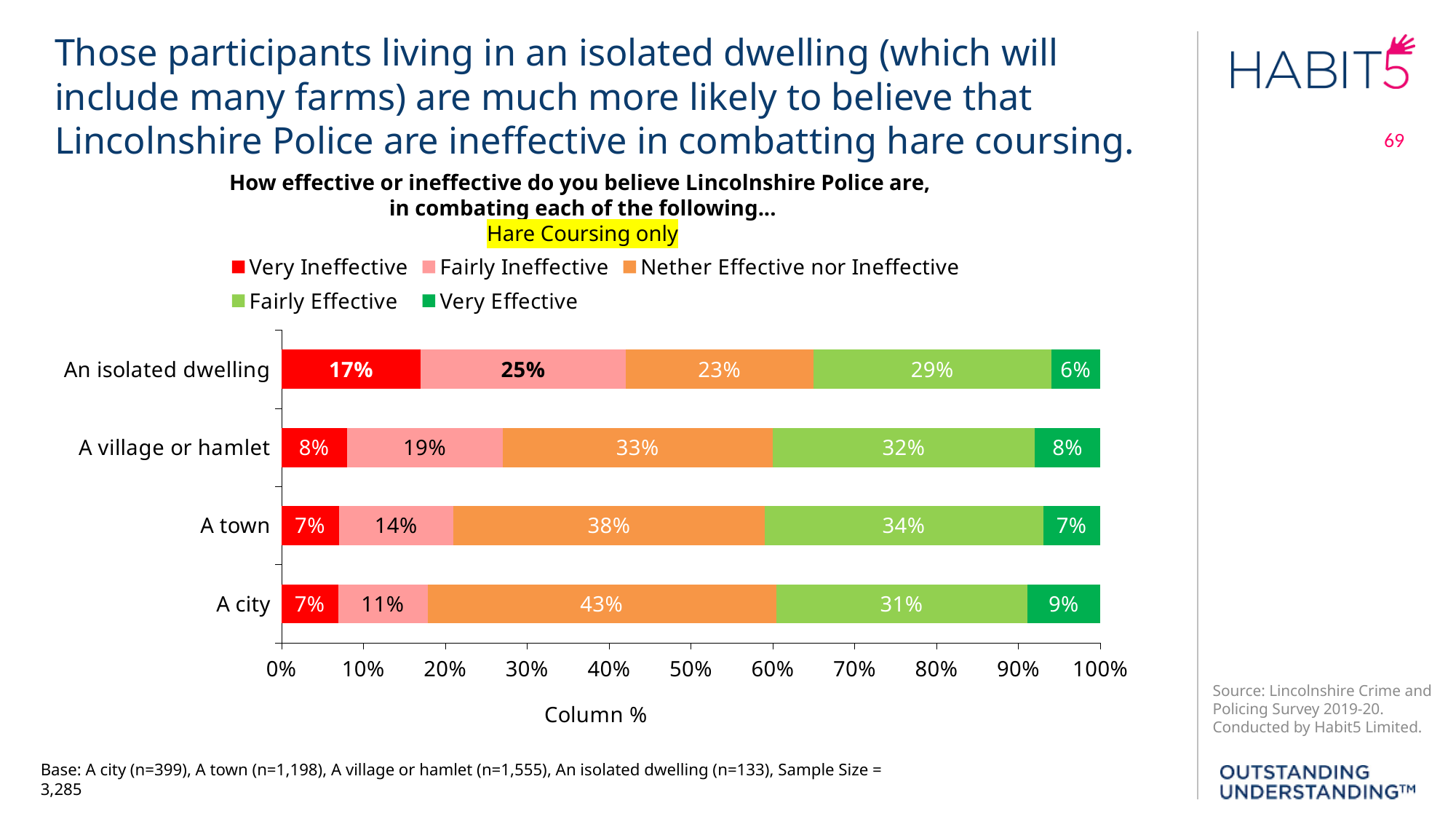
What is the label on the x axis of the chart? Column % How many series does the legend list? 5 What kind of chart is shown on the slide? Stacked bar chart What is the Fairly Effective value for A town? 34% What percentage of participants living in an isolated dwelling said Lincolnshire Police are Very Ineffective at combating hare coursing? 17% Which is larger: the Nether Effective nor Ineffective value for A village or hamlet or for A town? A town What is the difference between the Fairly Ineffective values for An isolated dwelling and A town? 11% What is the Very Effective value for A village or hamlet? 8% What is the Nether Effective nor Ineffective value for A city? 43% How many categories are shown on the y axis? 4 Which category has the lowest Fairly Ineffective value? A city Which category has the highest Very Ineffective value? An isolated dwelling